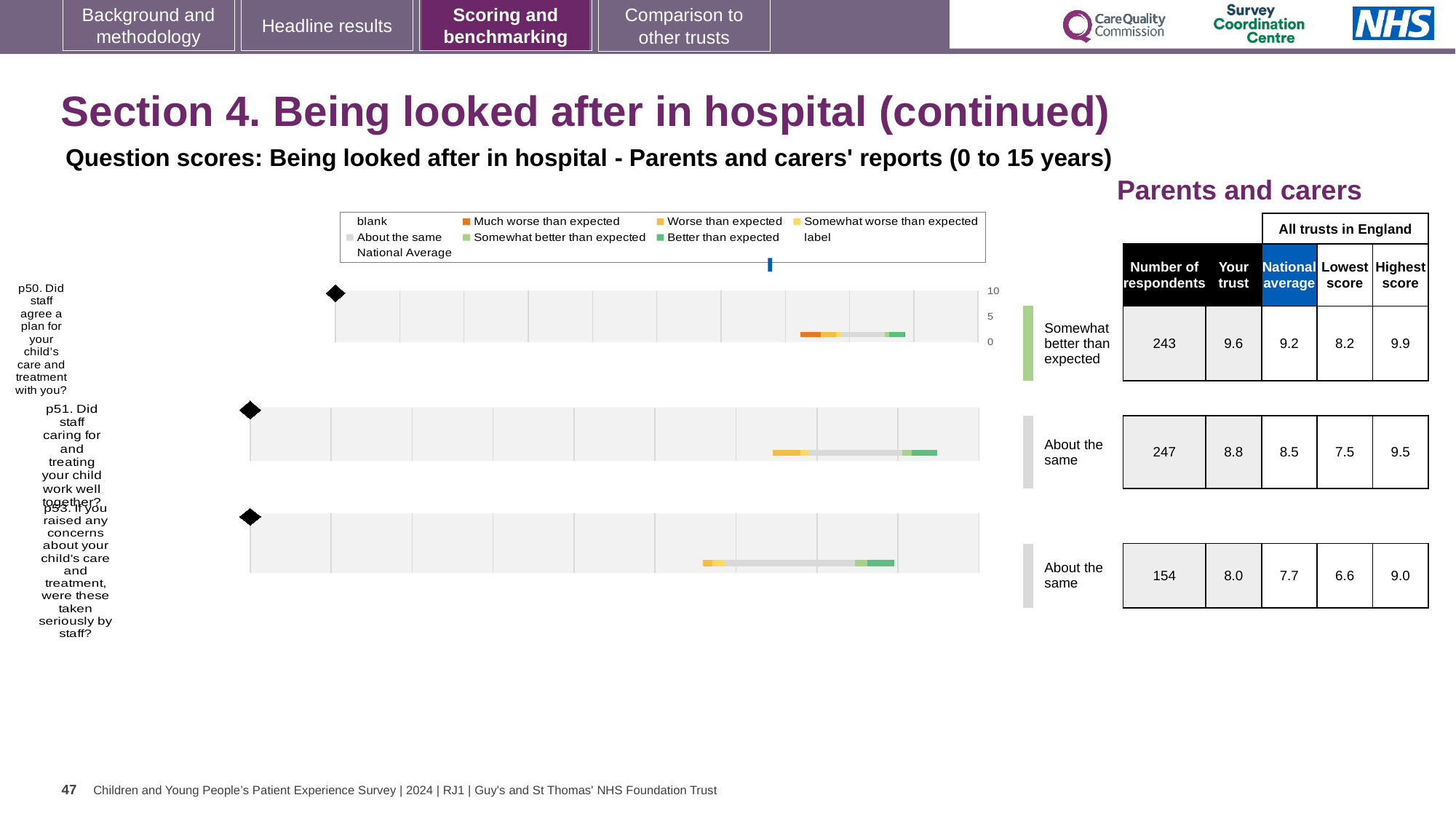
What is the difference between the 'Your trust' score and the national average for p50? 0.4 Which question has the lowest 'Your trust' score? p53 For p51, which is larger: the 'Your trust' score or the national average? Your trust What is the lowest score among all trusts in England for p53? 6.6 How many questions are plotted on the slide? 3 Which benchmark category is p50 placed in? Somewhat better than expected What is the highest score among all trusts in England for p50? 9.9 What is the 'Your trust' score for p50 (Did staff agree a plan for your child's care and treatment with you)? 9.6 What is the national average score for p51 (Did staff caring for and treating your child work well together)? 8.5 What kind of chart is used to show the question scores for p50, p51 and p53? bar chart Which question has the highest 'Your trust' score? p50 How many respondents answered p53 (If you raised any concerns about your child's care and treatment, were these taken seriously by staff)? 154